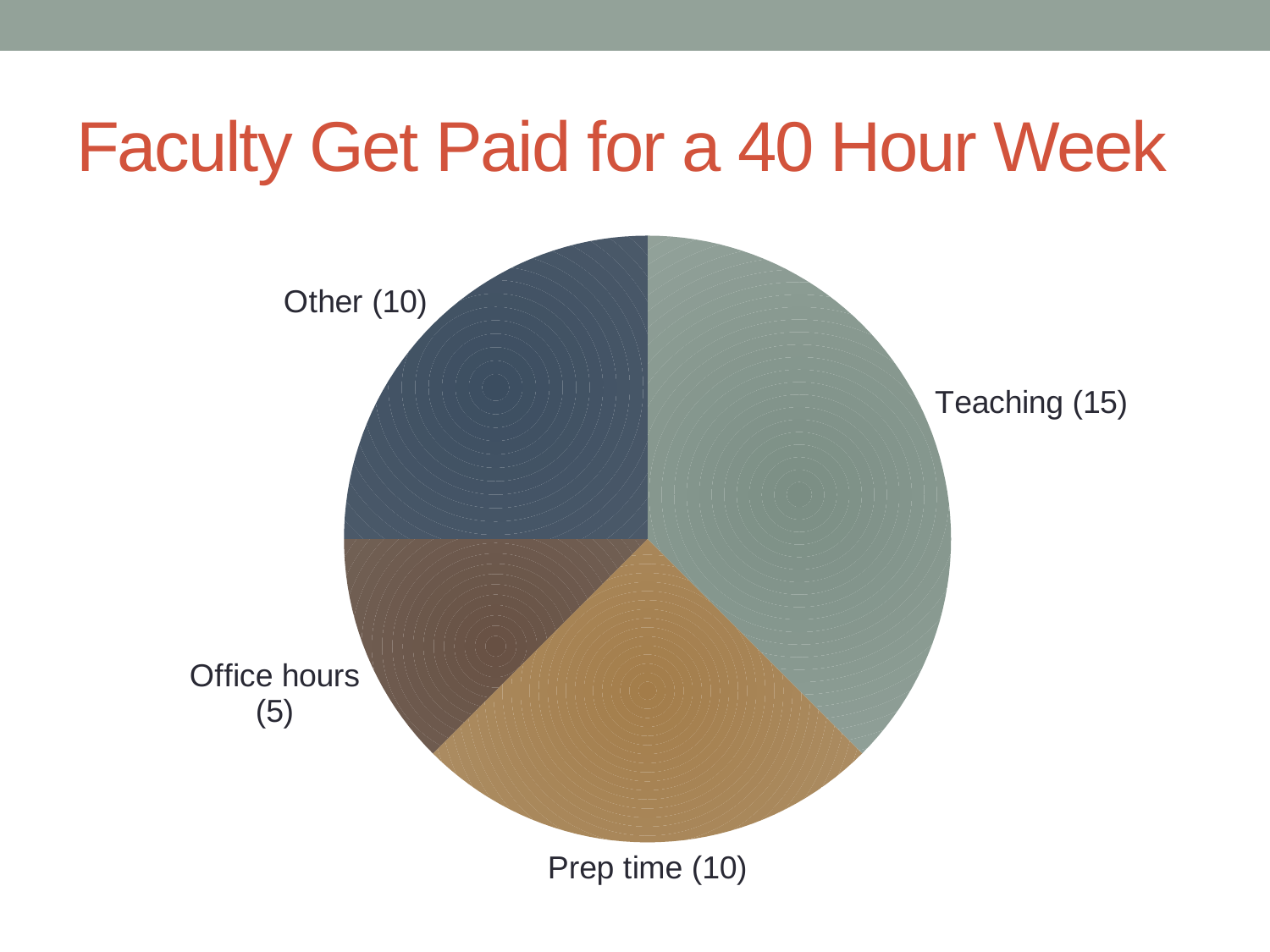
What is the difference in hours between Teaching and Office hours? 10 What kind of chart is shown on the slide? Pie chart How many categories does the pie chart show? 4 How many hours are shown for Office hours? 5 What is the title of the slide? Faculty Get Paid for a 40 Hour Week What share of the pie does Teaching represent? 37.5% What is the total number of hours across all slices? 40 Which category has the largest slice of the pie? Teaching Which is larger, Prep time or Office hours? Prep time Which category has the smallest slice of the pie? Office hours How many hours are shown for Teaching? 15 How many hours are shown for Prep time? 10